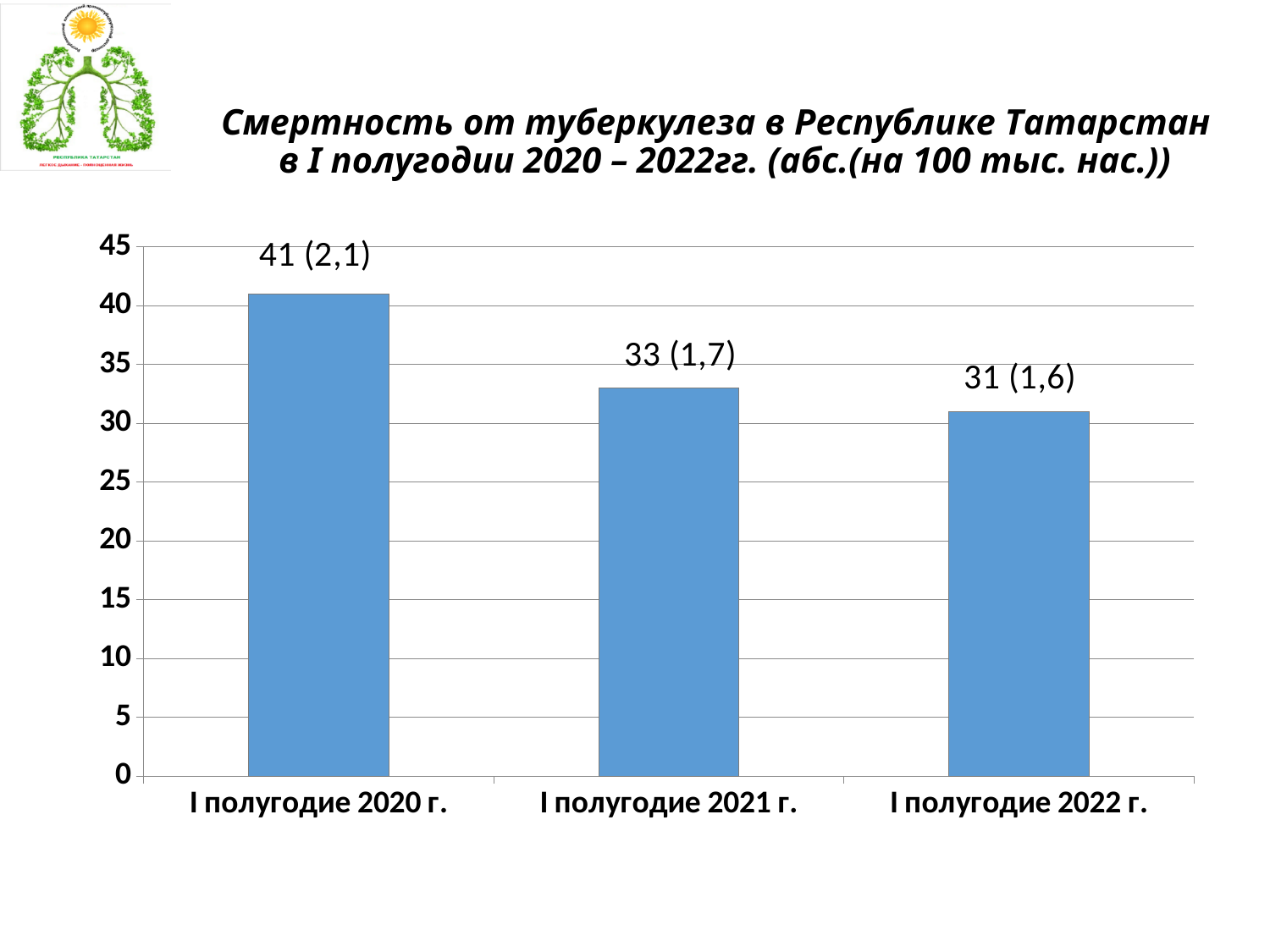
What is the difference between the absolute values for I полугодие 2021 г. and I полугодие 2022 г.? 2 What is the data label shown for I полугодие 2021 г.? 33 (1,7) Which period has the lowest value? I полугодие 2022 г. How many periods are shown on the x axis? 3 What kind of chart is shown on the slide? bar chart What is the data label shown for I полугодие 2020 г.? 41 (2,1) Do the values rise or fall from I полугодие 2020 г. to I полугодие 2022 г.? fall Is the value for I полугодие 2021 г. greater or less than 30? greater What is the difference between the absolute values for I полугодие 2020 г. and I полугодие 2022 г.? 10 What is the data label shown for I полугодие 2022 г.? 31 (1,6) Which is larger, the value for I полугодие 2020 г. or I полугодие 2021 г.? I полугодие 2020 г. Which period has the highest value? I полугодие 2020 г.